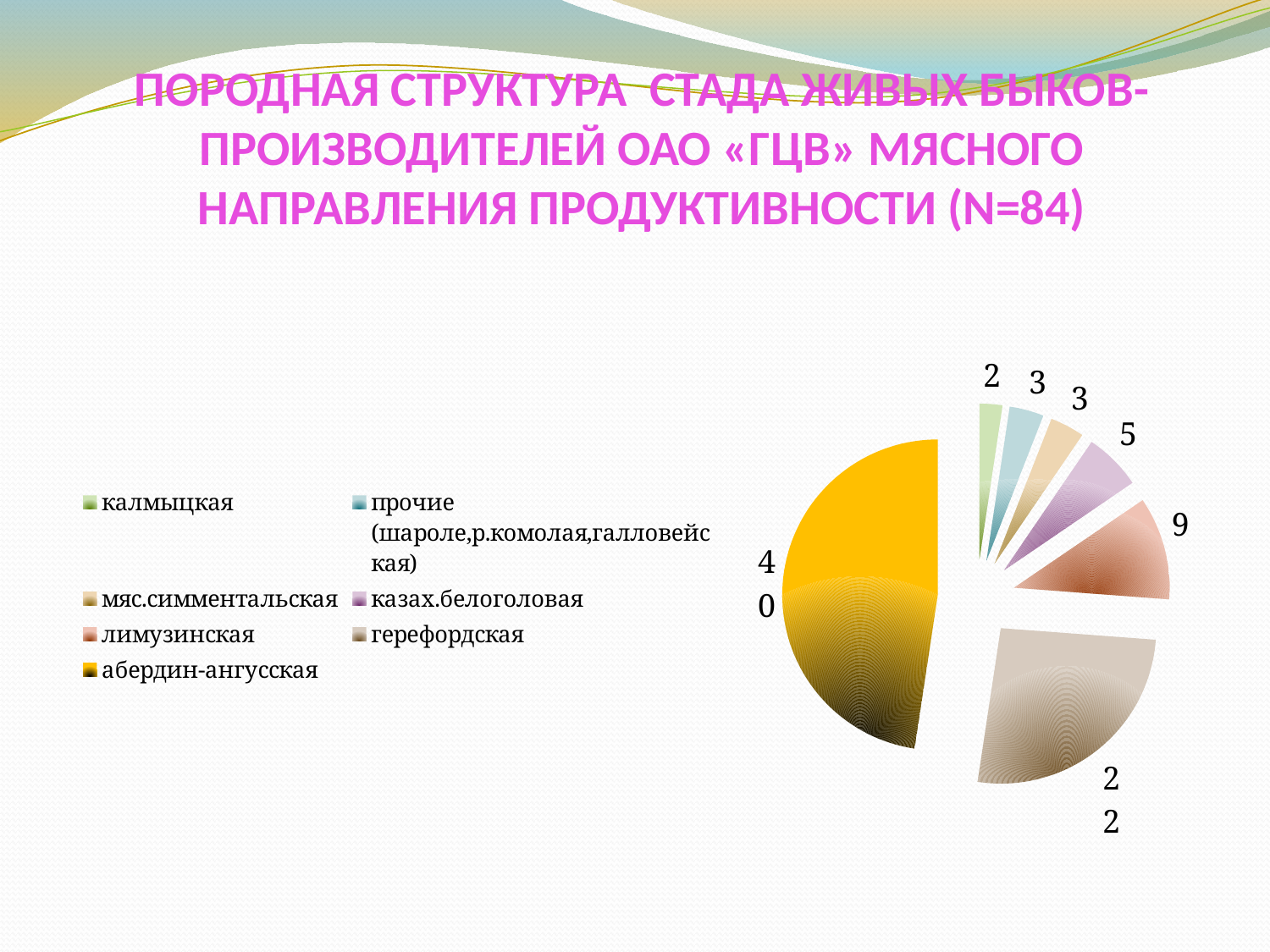
What is the value for лимузинская? 9 Which is larger, the value for лимузинская or the value for казах.белоголовая? лимузинская What is the sum of all the slice values in the pie chart? 84 What is the value for казах.белоголовая? 5 What kind of chart is shown on the slide? pie chart How many slices (breeds) does the pie chart have? 7 What is the difference between the values for абердин-ангусская and герефордская? 18 Which breed has the smallest slice of the pie? калмыцкая Which breed has the largest slice of the pie? абердин-ангусская What is the value for абердин-ангусская? 40 What is the value for герефордская? 22 What is the value for калмыцкая? 2